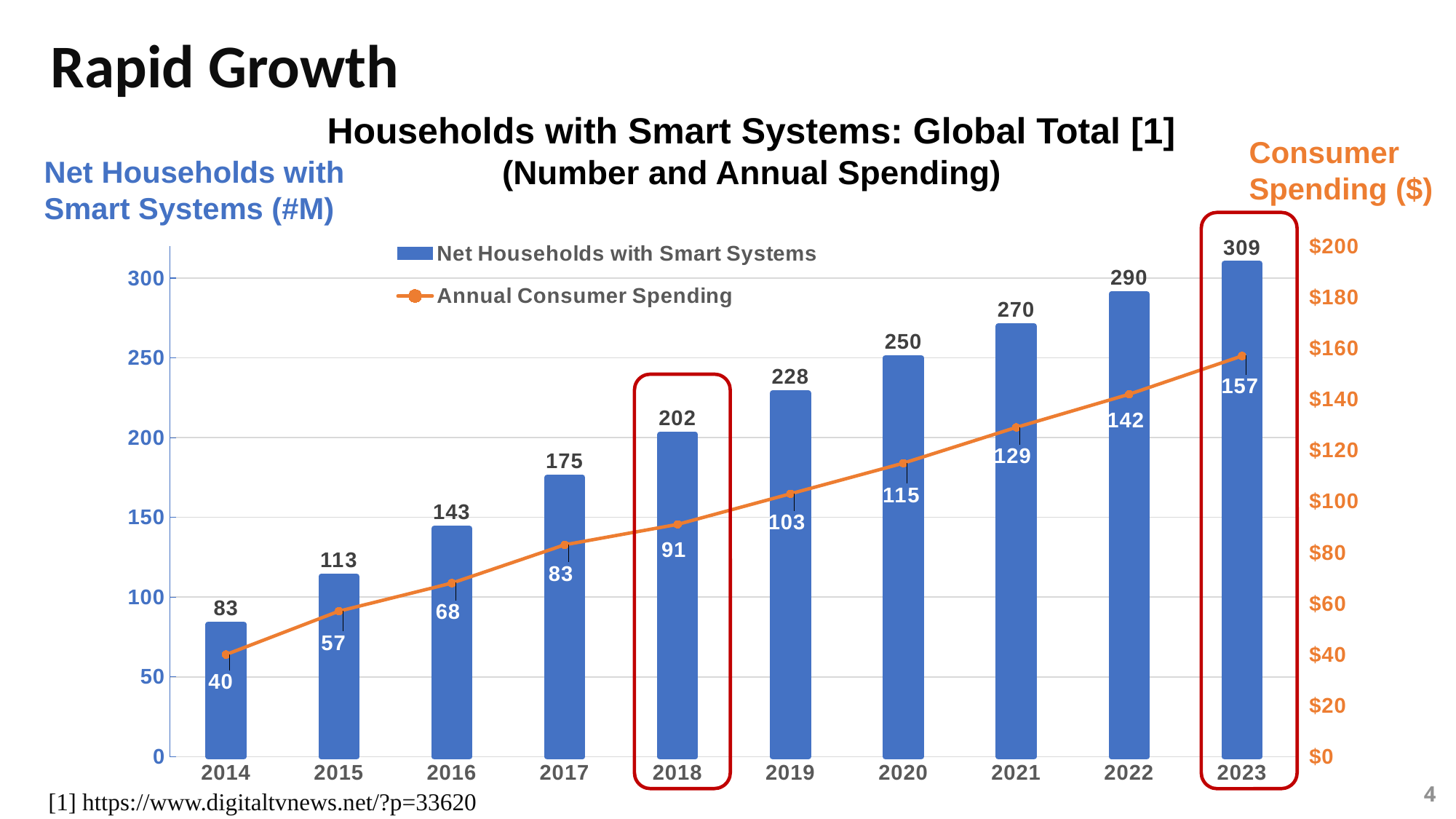
Which year has the lowest Annual Consumer Spending value? 2014 How many series does the legend list? 2 What is the title of the chart? Households with Smart Systems: Global Total [1] (Number and Annual Spending) What is the Annual Consumer Spending value for 2023? 157 Which is larger: the Annual Consumer Spending value for 2020 or for 2017? 2020 What is the difference between the Net Households with Smart Systems values for 2023 and 2018? 107 What is the value of Net Households with Smart Systems in 2018? 202 Does Annual Consumer Spending rise or fall from 2014 to 2023? rise What kind of chart is used for the Net Households with Smart Systems series? bar chart How many years are shown on the x axis? 10 Which year has the highest Net Households with Smart Systems value? 2023 Is the Net Households with Smart Systems value for 2021 greater or less than 250? greater